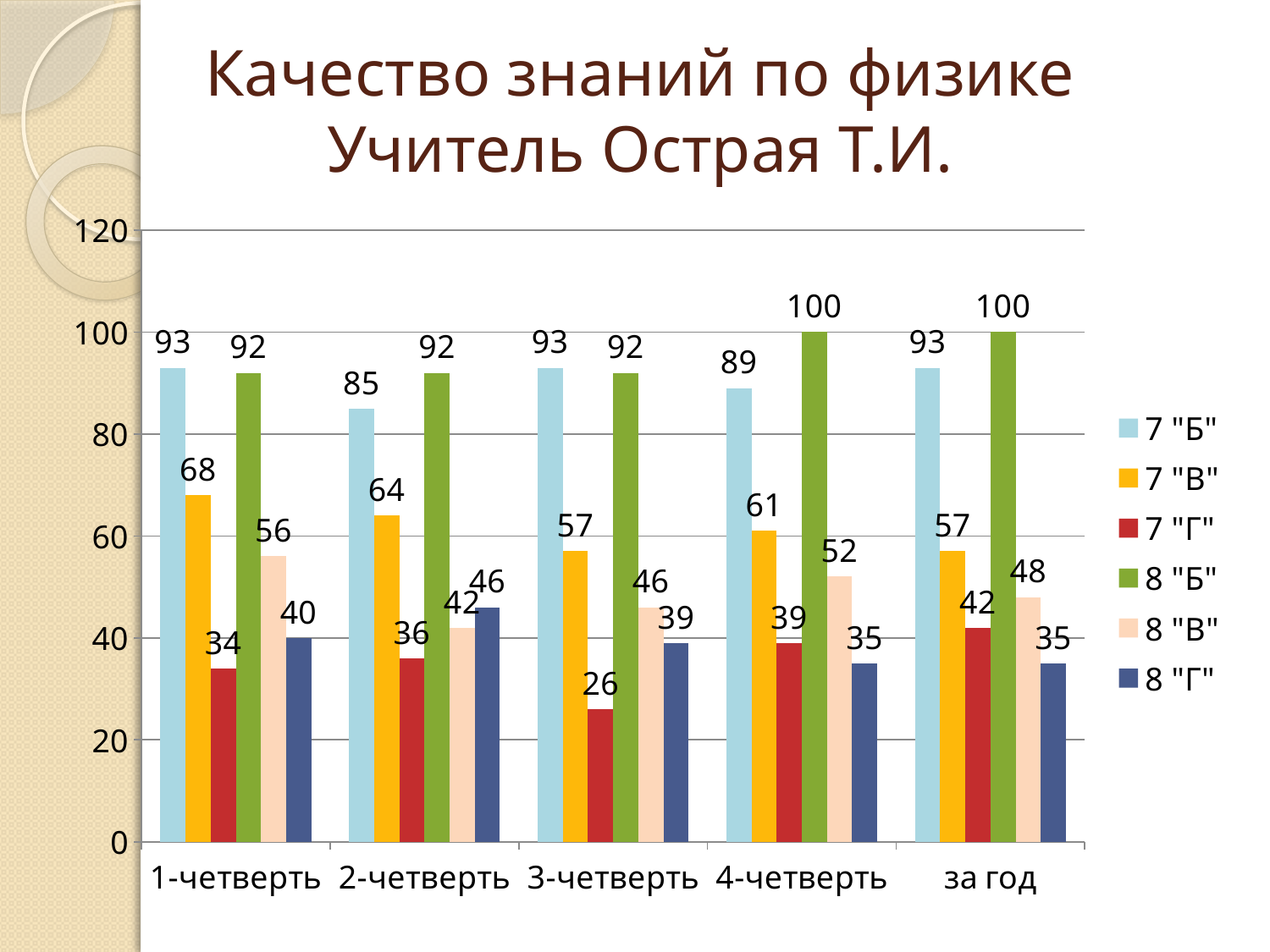
What kind of chart is shown on the slide? bar chart Which series has the highest value in за год? 8 "Б" Does the value for 7 "Г" rise or fall from 1-четверть to 2-четверть? rise What is the value for 7 "Г" in 3-четверть? 26 How many series does the legend list? 6 What is the value for 7 "В" in 1-четверть? 68 Which series has the lowest value in 2-четверть? 7 "Г" What is the difference between 7 "Б" and 7 "В" in 4-четверть? 28 What is the value for 8 "Б" in 4-четверть? 100 What is the value for 8 "В" in за год? 48 Which is larger in 1-четверть: 8 "В" or 8 "Г"? 8 "В" How many categories are shown on the x axis? 5